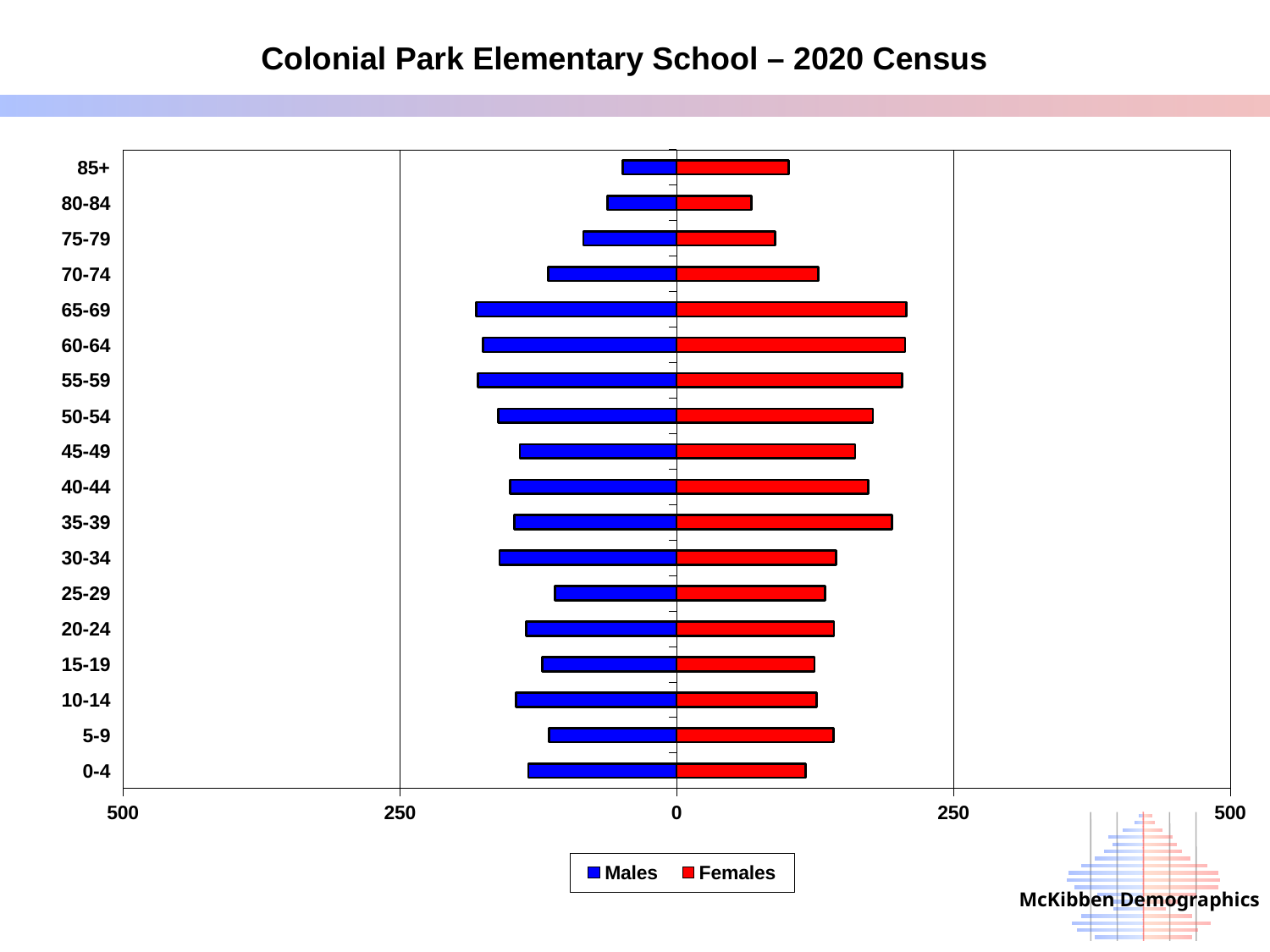
What kind of chart is shown on the slide? bar chart Which age group has the smallest Males value? 85+ Is the Females value for the 65-69 age group greater or less than 250? less How many series does the legend list? 2 What is the title of the chart? Colonial Park Elementary School – 2020 Census Which colour represents Females in the chart? red How many age groups are shown on the vertical axis? 18 Is the Males value for the 85+ age group greater or less than 250? less Which is larger, the Males value for 65-69 or the Males value for 25-29? 65-69 Which is larger, the Females value for 35-39 or the Females value for 0-4? 35-39 For the 85+ age group, which is larger, the Males value or the Females value? Females Which age group has the smallest Females value? 80-84